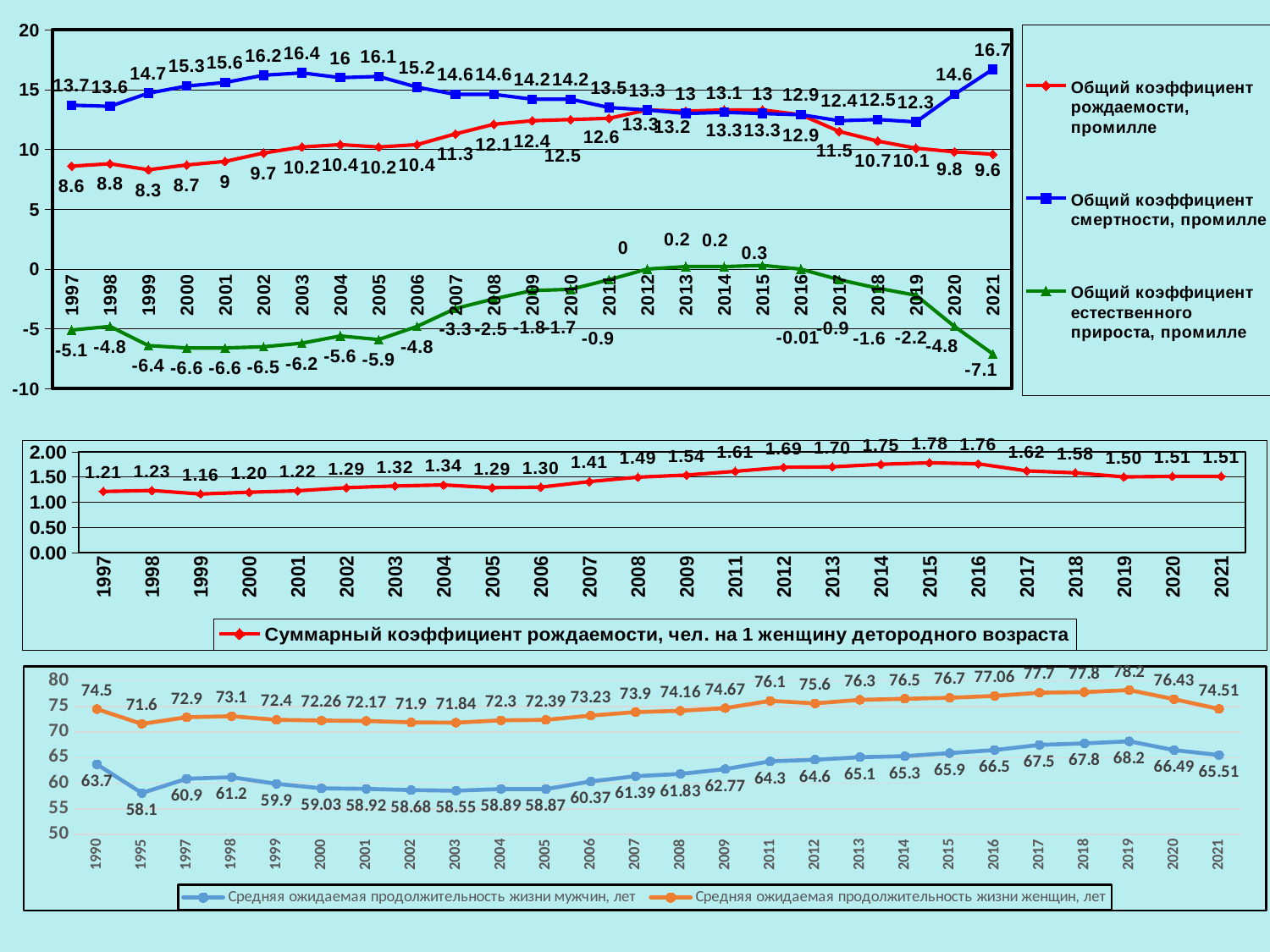
In the middle chart, in which year is the total fertility rate lowest? 1999 In the top chart, what is the difference between the mortality rate and the birth rate in 2003? 6.2 How many series does the legend of the top chart list? 3 In the middle chart, what is the total fertility rate (Суммарный коэффициент рождаемости) in 2015? 1.78 What type of chart is the middle chart? line chart In the top chart, what is the general birth rate (Общий коэффициент рождаемости) in 2007? 11.3 In the bottom chart, what is the difference between women's and men's life expectancy in 1995? 13.5 In the bottom chart, how many years (data points) are plotted along the x axis? 26 In the top chart, which is larger in 2015: the birth rate or the mortality rate? the birth rate In the top chart, in which year does the general mortality rate reach its lowest value? 2019 In the top chart, what is the value of the general mortality rate (Общий коэффициент смертности) in 2021? 16.7 In the bottom chart, what is the average life expectancy of women in 2019? 78.2